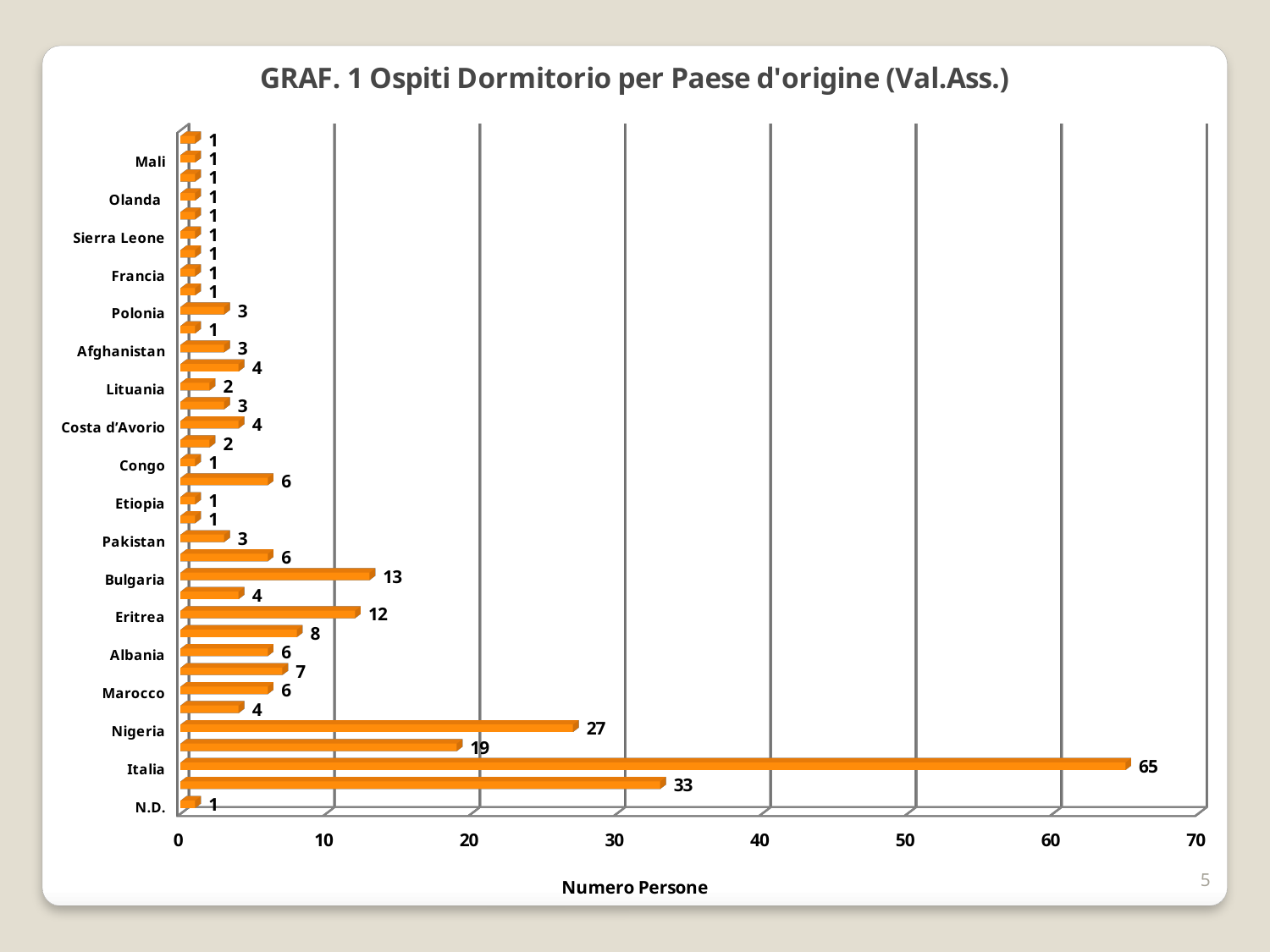
What is the value for Italia? 65 What is the title of the horizontal axis? Numero Persone What is the value for Eritrea? 12 Is the value for Italia greater or less than 60? greater What kind of chart is shown on the slide? Bar chart What is the difference between the values for Italia and Nigeria? 38 What is the value for Costa d'Avorio? 4 Which country has the highest number of people? Italia What is the value for Nigeria? 27 What is the value for Bulgaria? 13 What is the value for Polonia? 3 Which is larger, the value for Bulgaria or the value for Eritrea? Bulgaria